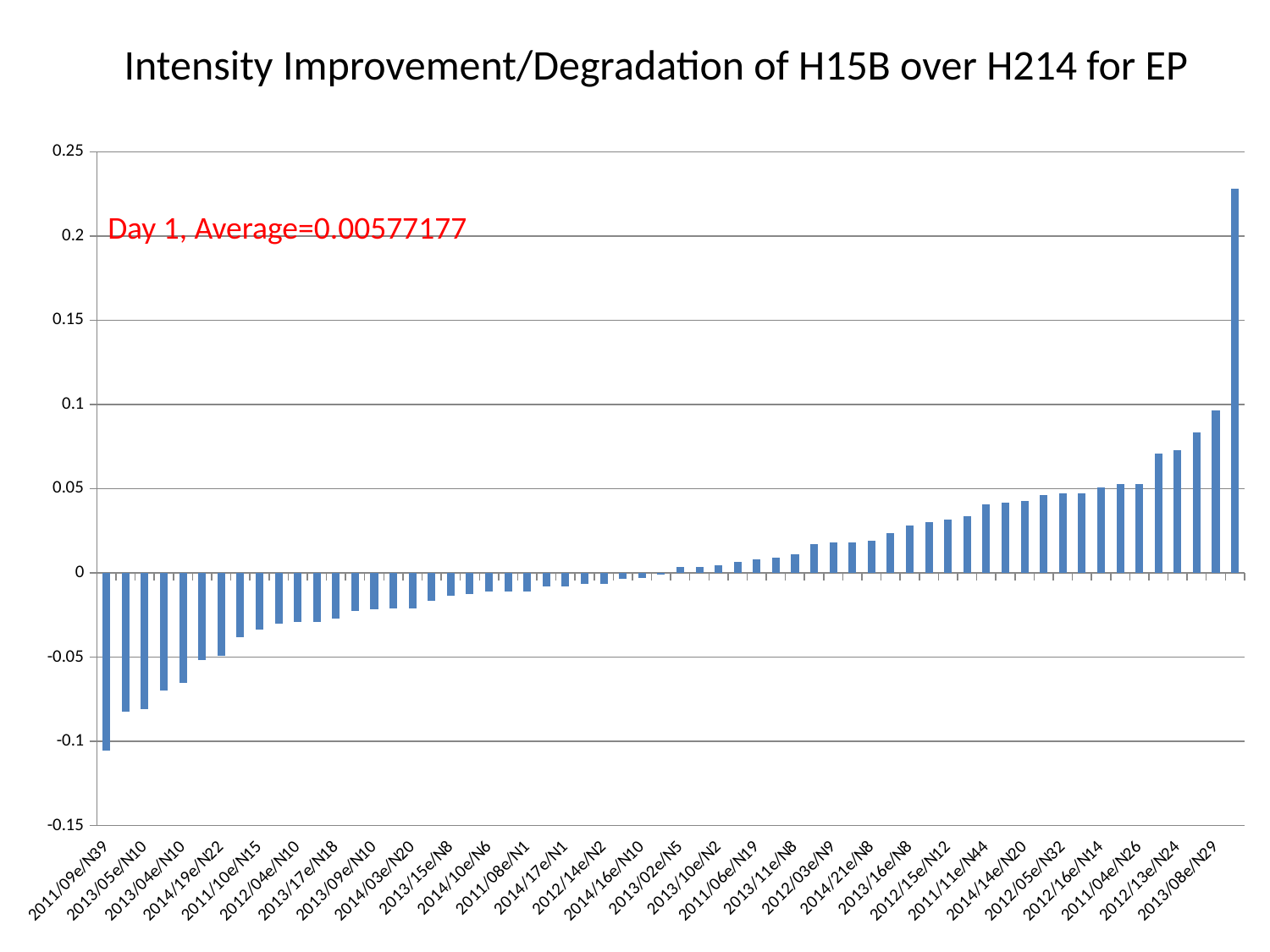
Is the value for 2013/08e/N29 greater or less than 0.05? greater Which has the larger value, 2011/09e/N39 or 2013/08e/N29? 2013/08e/N29 Is the value for 2012/03e/N9 greater or less than 0.05? less What is the title of the chart? Intensity Improvement/Degradation of H15B over H214 for EP Is the value for 2013/05e/N10 greater or less than -0.05? less What kind of chart is shown on the slide? bar chart What average value is stated in the red annotation on the chart? 0.00577177 Do the bar values rise or fall moving from left to right along the x axis? rise Which category has the lowest value? 2011/09e/N39